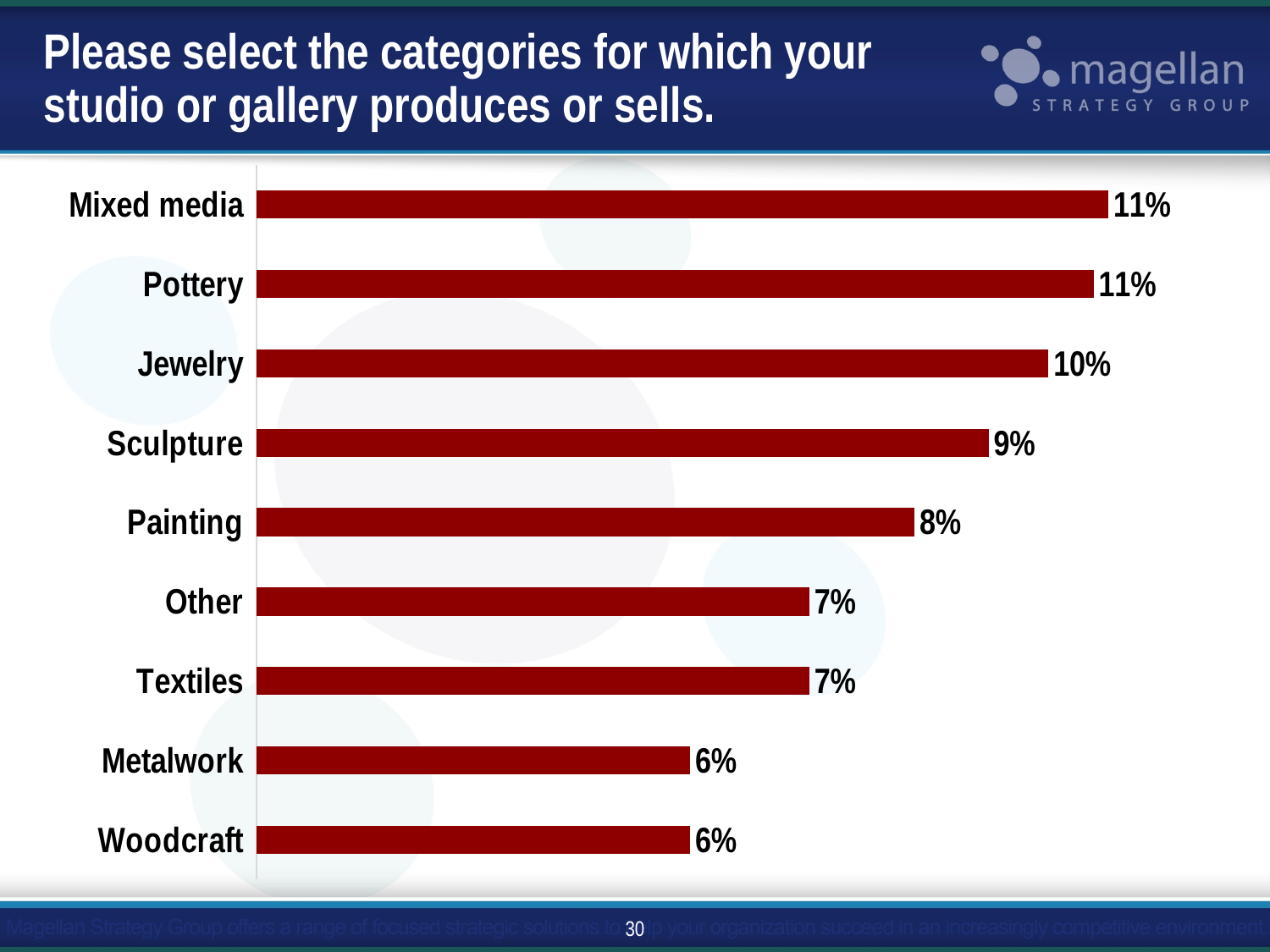
What is the value for Mixed media? 11% What kind of chart is shown on the slide? Bar chart Which is larger, the value for Jewelry or the value for Painting? Jewelry What percentage is shown for Painting? 8% What is the difference between the values for Jewelry and Painting? 2% What is the difference between the values for Pottery and Woodcraft? 5% What is the value for Textiles? 7% What percentage is shown for Jewelry? 10% What is the value for Sculpture? 9% Which is larger, the value for Sculpture or the value for Metalwork? Sculpture How many categories are shown in the chart? 9 What percentage is shown for Woodcraft? 6%